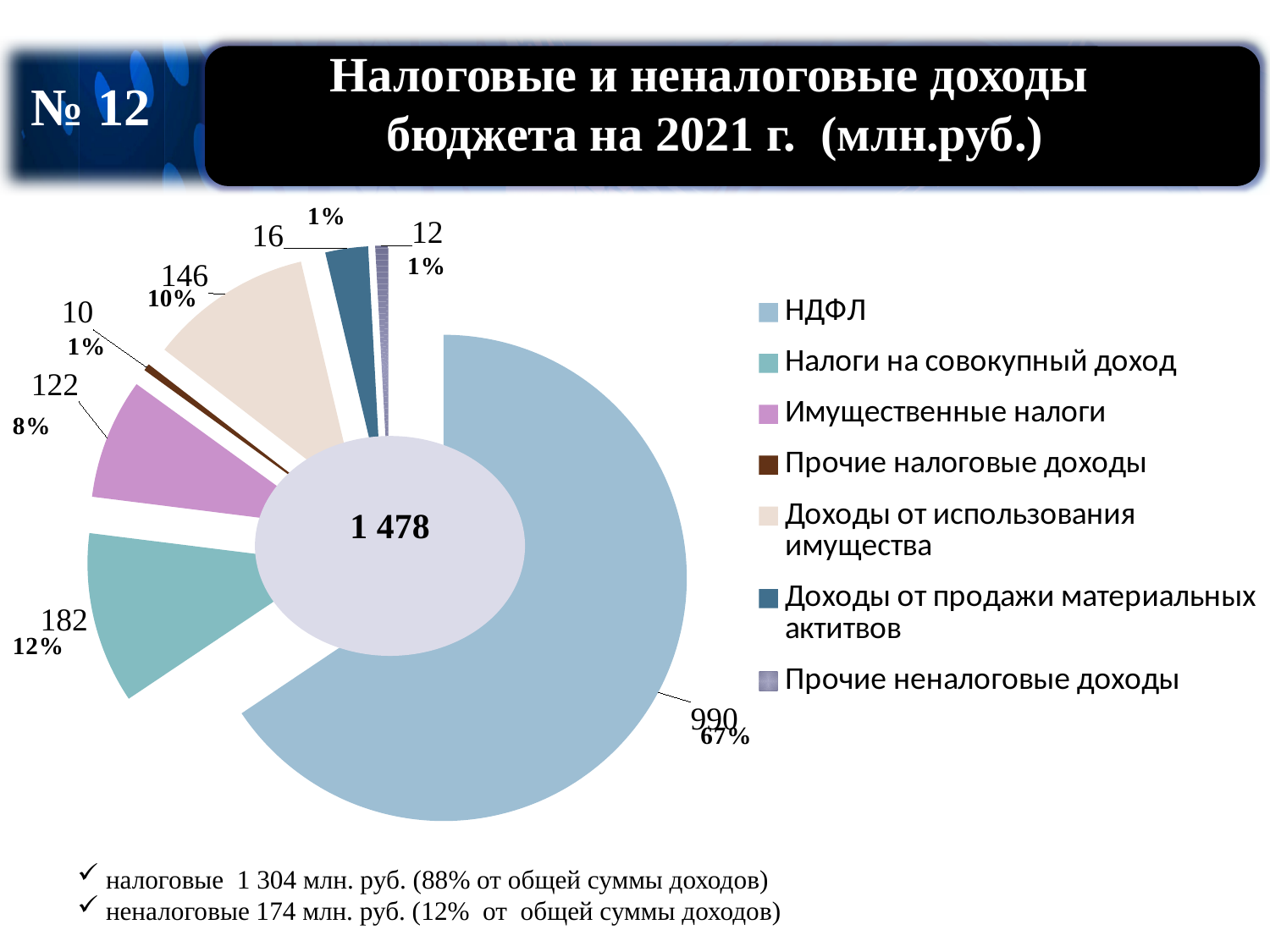
What share of the pie does НДФЛ represent? 67% What is the difference between the values for НДФЛ and Налоги на совокупный доход? 808 Which is larger, Доходы от использования имущества or Имущественные налоги? Доходы от использования имущества What is the value for НДФЛ? 990 How many categories does the legend list? 7 What is the value for Имущественные налоги? 122 What is the value for Налоги на совокупный доход? 182 Which category has the largest slice? НДФЛ What kind of chart is shown on the slide? pie chart What is the value for Доходы от использования имущества? 146 What share of the pie does Имущественные налоги represent? 8% What total value is shown in the centre of the chart? 1 478